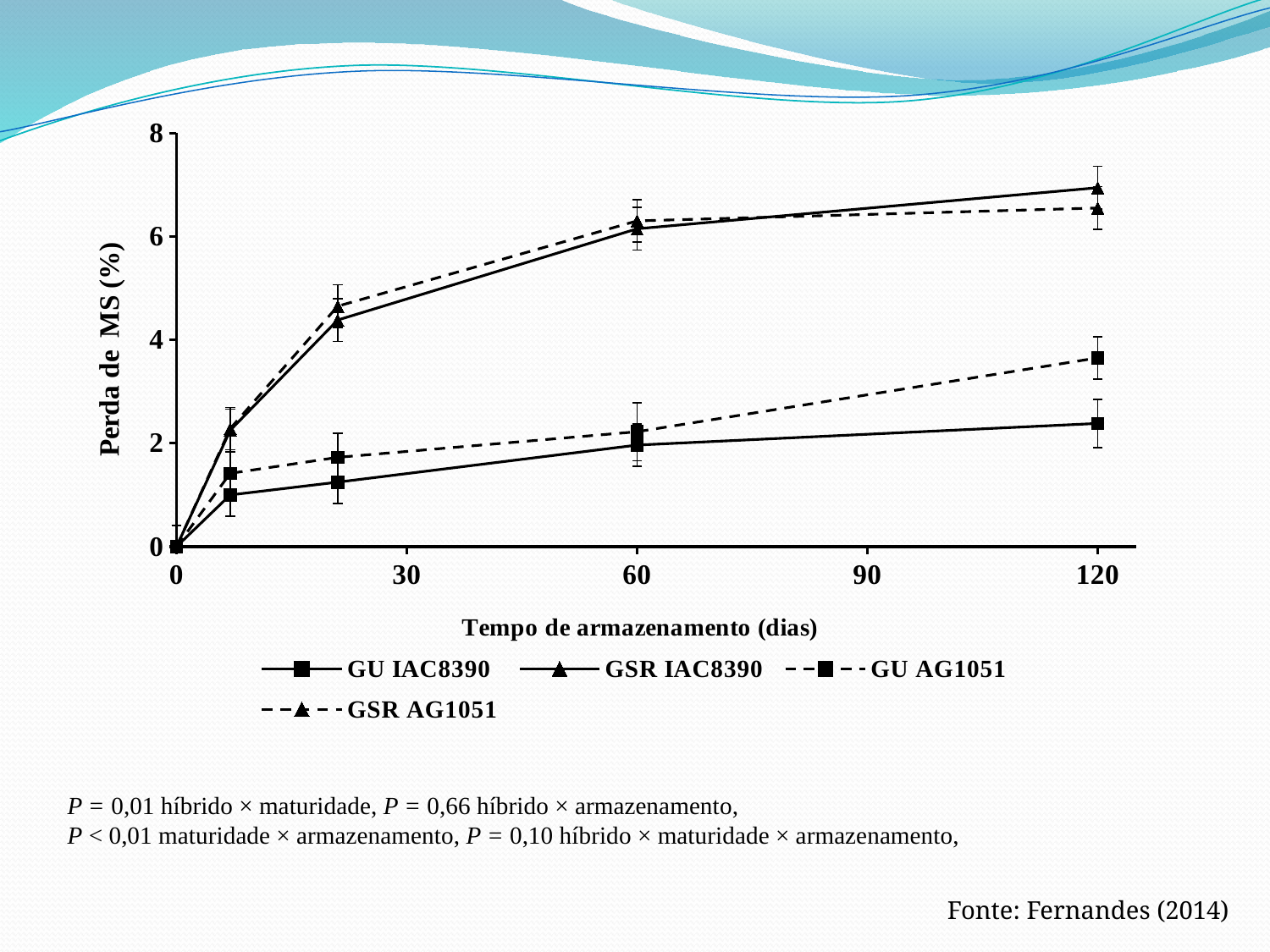
Is the value for GU AG1051 at 120 days greater or less than 2? greater Which series has the lowest value at 120 days? GU IAC8390 What kind of chart is shown on the slide? line chart How many series does the legend list? 4 What is the title of the y axis? Perda de MS (%) Is the value for GU IAC8390 at 120 days greater or less than 4? less What is the title of the x axis? Tempo de armazenamento (dias) Do the values for GSR IAC8390 rise or fall as storage time increases? rise Is the value for GSR AG1051 at 60 days greater or less than 4? greater At 120 days, which is larger: GU AG1051 or GU IAC8390? GU AG1051 At 60 days, which is larger: GSR AG1051 or GU AG1051? GSR AG1051